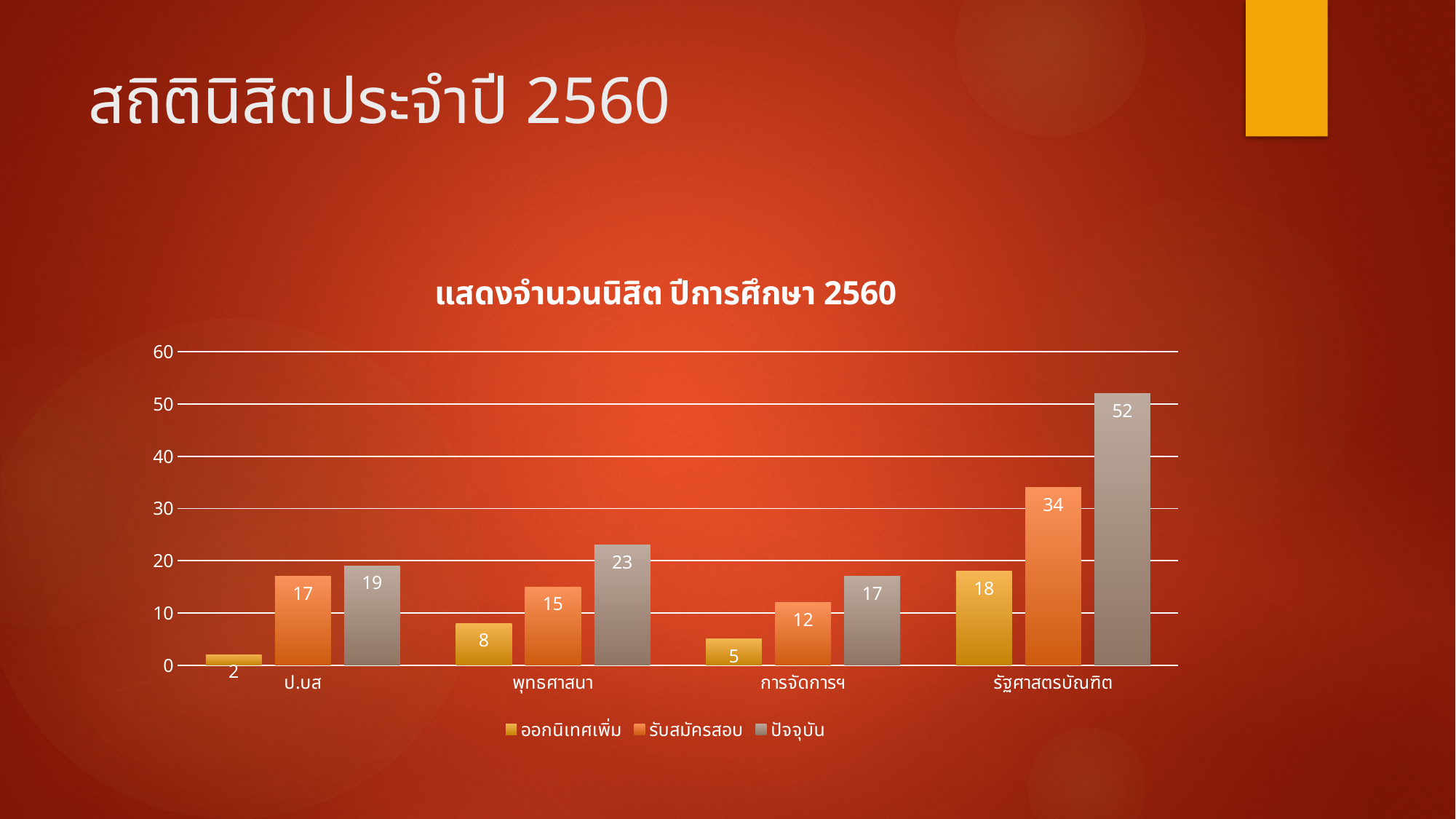
Which category has the lowest ออกนิเทศเพิ่ม value? ป.บส Which category has the highest ปัจจุบัน value? รัฐศาสตรบัณฑิต Which is larger: the ปัจจุบัน value for พุทธศาสนา or for ป.บส? พุทธศาสนา How many categories are shown on the x axis? 4 What is the value of ปัจจุบัน for การจัดการฯ? 17 What is the title of the chart? แสดงจำนวนนิสิต ปีการศึกษา 2560 What kind of chart is shown on the slide? Bar chart How many series does the legend list? 3 What is the difference between the รับสมัครสอบ value for รัฐศาสตรบัณฑิต and for ป.บส? 17 What is the value of รับสมัครสอบ for พุทธศาสนา? 15 What is the value of ออกนิเทศเพิ่ม for ป.บส? 2 What is the value of ปัจจุบัน for รัฐศาสตรบัณฑิต? 52